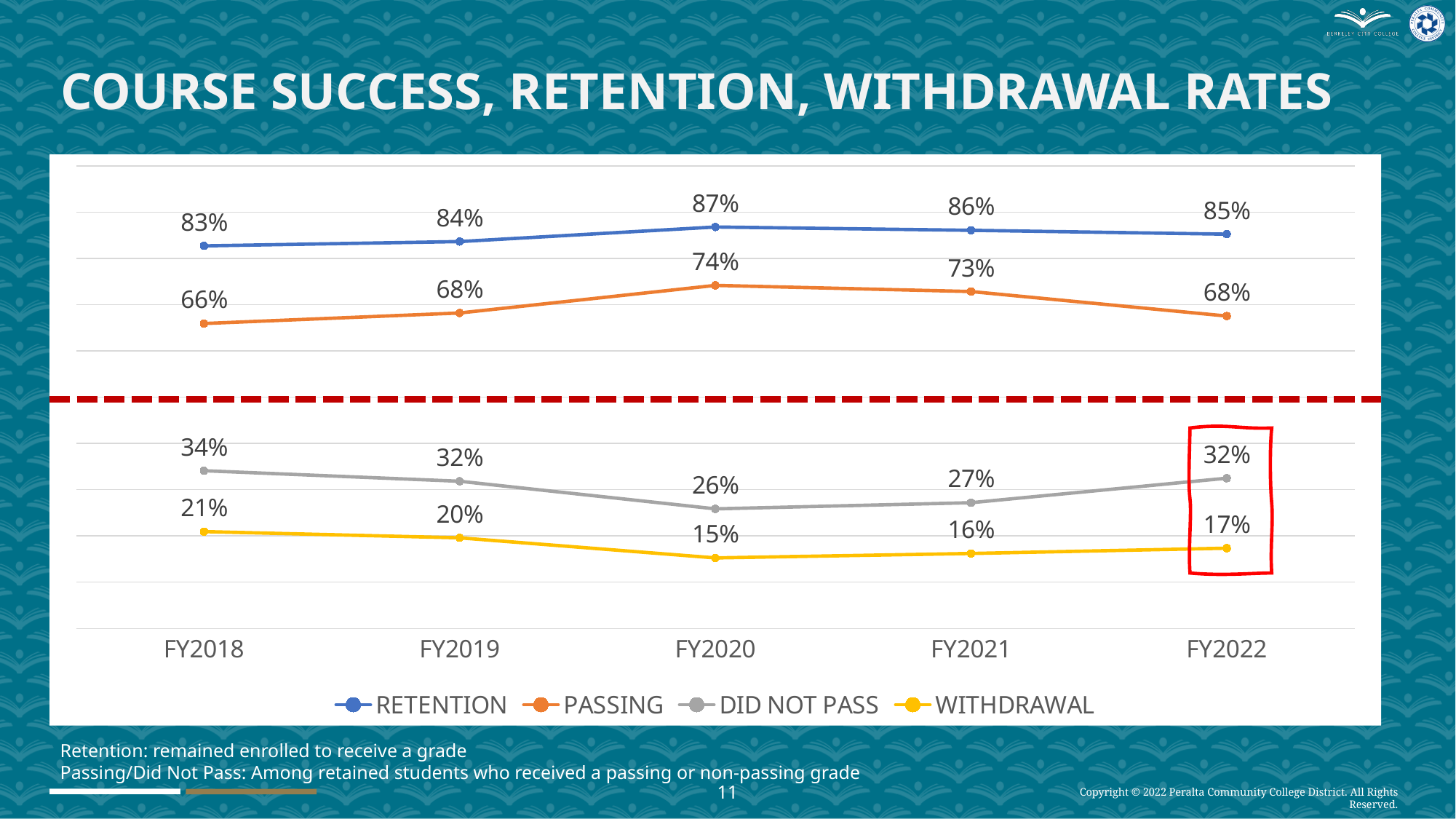
In which fiscal year is the WITHDRAWAL rate lowest? FY2020 How many fiscal years are shown on the x axis? 5 Which is larger, the DID NOT PASS rate in FY2018 or in FY2022? FY2018 In which fiscal year is the PASSING rate highest? FY2020 What is the difference between the RETENTION rate and the PASSING rate in FY2022? 17% What kind of chart is shown on the slide? Line chart How many series does the legend list? 4 What is the PASSING rate for FY2018? 66% What is the WITHDRAWAL rate for FY2022? 17% Does the PASSING rate rise or fall from FY2021 to FY2022? Fall What is the DID NOT PASS rate for FY2021? 27% What is the RETENTION rate for FY2020? 87%